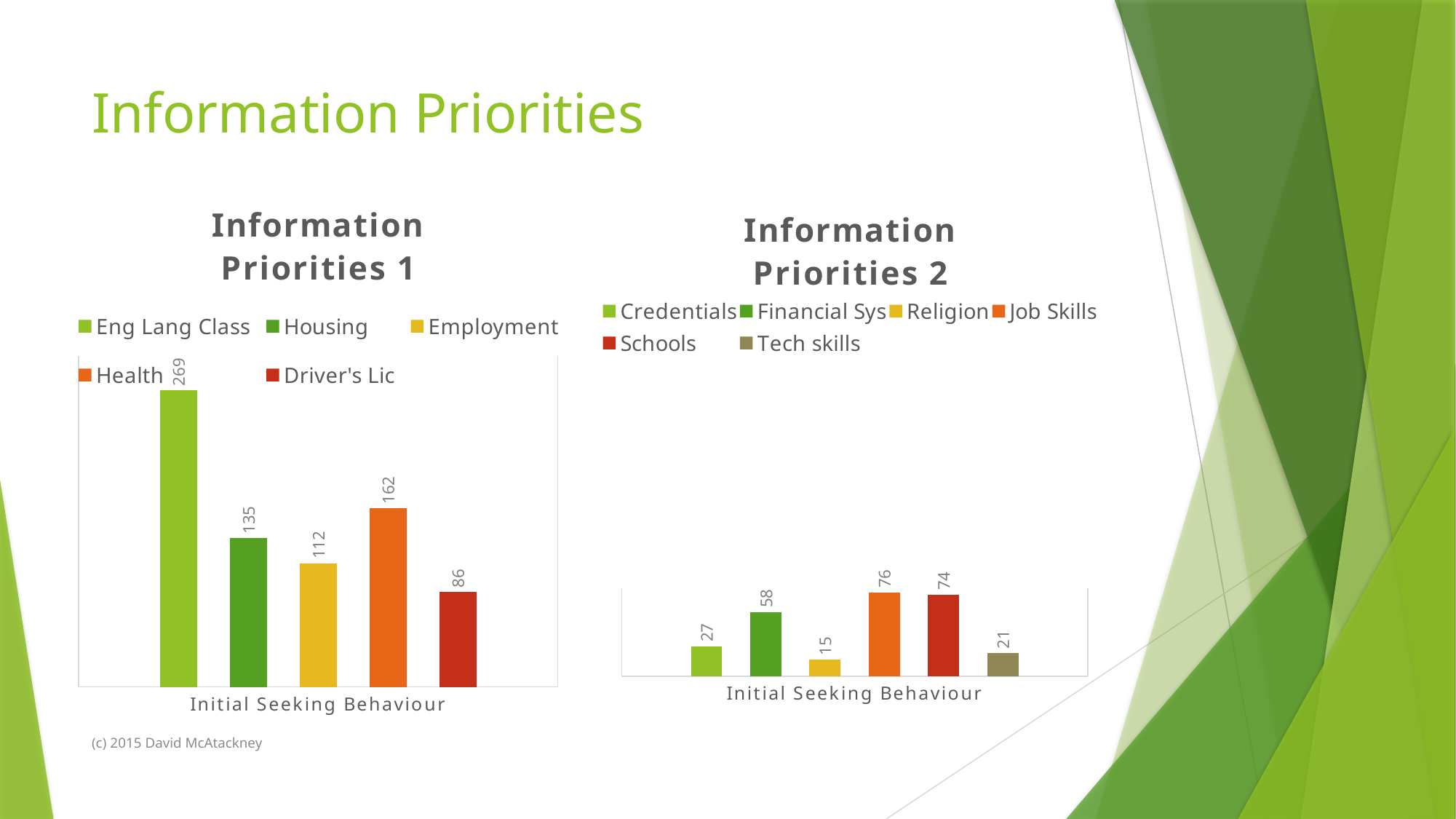
In the Information Priorities 1 chart, what is the value for Eng Lang Class? 269 In the Information Priorities 1 chart, how many series does the legend list? 5 In the Information Priorities 1 chart, what is the value for Health? 162 In the Information Priorities 2 chart, which series has the highest value? Job Skills In the Information Priorities 1 chart, what is the difference between the Housing and Employment values? 23 In the Information Priorities 2 chart, which is larger, Credentials or Tech skills? Credentials In the Information Priorities 2 chart, what is the value for Religion? 15 In the Information Priorities 2 chart, what is the value for Financial Sys? 58 What kind of chart is the Information Priorities 2 chart? Bar chart In the Information Priorities 2 chart, what is the difference between the Job Skills and Schools values? 2 In the Information Priorities 2 chart, how many series does the legend list? 6 In the Information Priorities 1 chart, which series has the lowest value? Driver's Lic